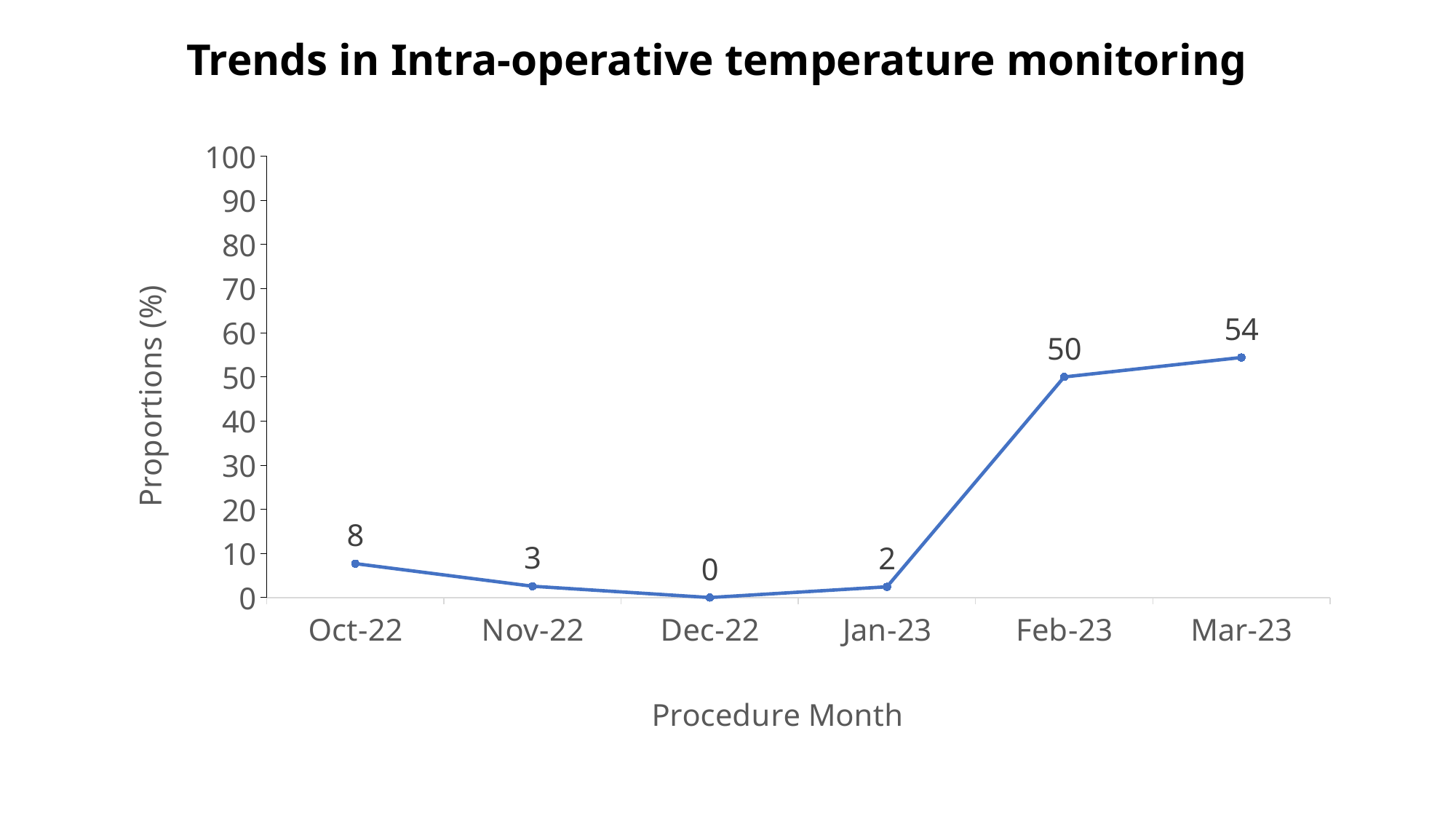
Which month has the lowest value? Dec-22 What is the title of the chart? Trends in Intra-operative temperature monitoring What is the value for Dec-22? 0 Which month has the highest value? Mar-23 Which is larger, the value for Oct-22 or the value for Nov-22? Oct-22 What is the value for Feb-23? 50 What is the value for Mar-23? 54 How many months are plotted on the x axis? 6 What kind of chart is shown? line chart Is the value for Mar-23 greater or less than 50? greater What is the difference between the values for Feb-23 and Jan-23? 48 What is the value for Oct-22? 8